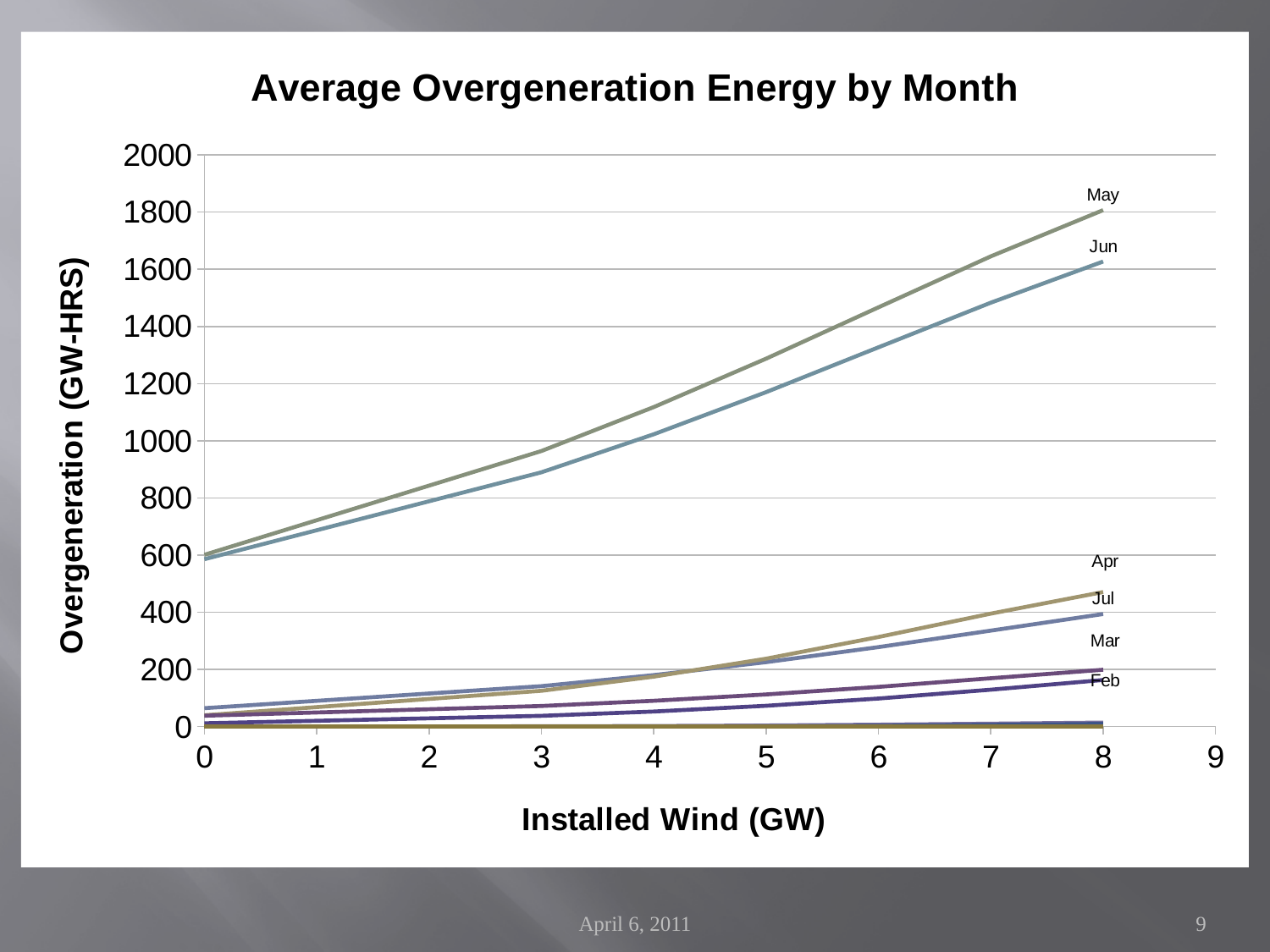
What is the label of the x axis? Installed Wind (GW) What kind of chart is shown on the slide? Line chart Does the overgeneration for May rise or fall as installed wind increases? Rises Which month has the highest overgeneration at 8 GW of installed wind? May What is the title of the chart? Average Overgeneration Energy by Month How many month labels are shown on the lines in the chart? 6 Is the value for Feb at 8 GW of installed wind greater or less than 200? less Is the value for Jun at 8 GW of installed wind greater or less than 1400? greater Is the value for May at 4 GW of installed wind greater or less than 1000? greater At 8 GW of installed wind, which is larger, the value for Apr or the value for Jul? Apr Of the labeled months, which has the lowest overgeneration at 8 GW of installed wind? Feb